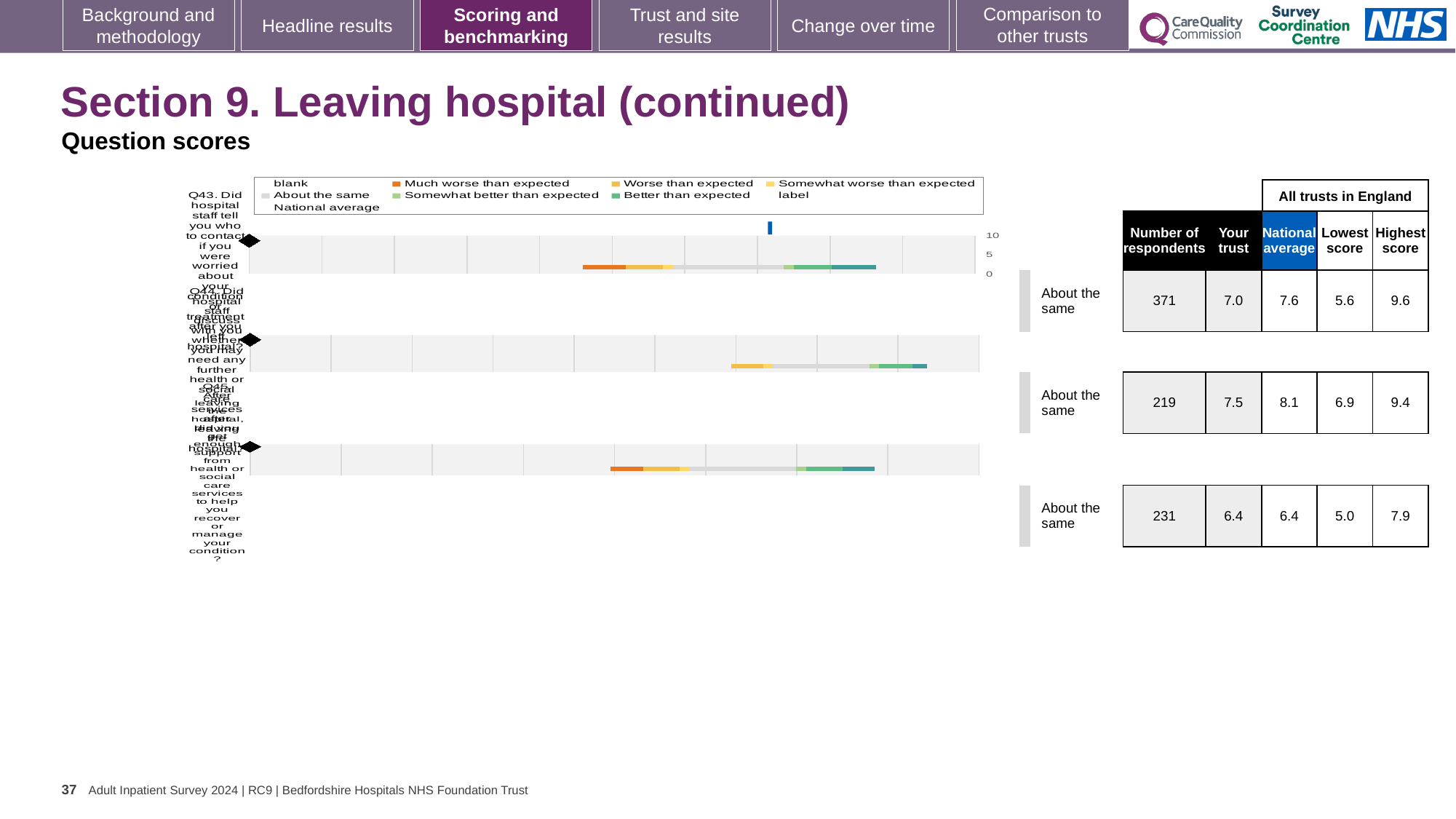
Which row of the table has the lowest 'Lowest score' value? the third (bottom) row, 5.0 In the table, what is the 'Your trust' score for the first (top) row, Q43? 7.0 What colour does the legend use for 'Much worse than expected'? orange In the table, what is the national average for the second (middle) row? 8.1 In the table, what is the number of respondents for the third (bottom) row? 231 For the third (bottom) row, is the 'Your trust' score higher than, lower than, or the same as the national average? the same In the table, what is the number of respondents for the first (top) row, Q43? 371 What kind of chart is shown on the slide? bar chart Which row of the table has the highest 'Highest score' value? the first (top) row, 9.6 For the first (top) row, what is the difference between the national average and the 'Your trust' score? 0.6 What benchmark category label is shown next to each of the three rows? About the same How many question rows (bars) are plotted in the chart? 3